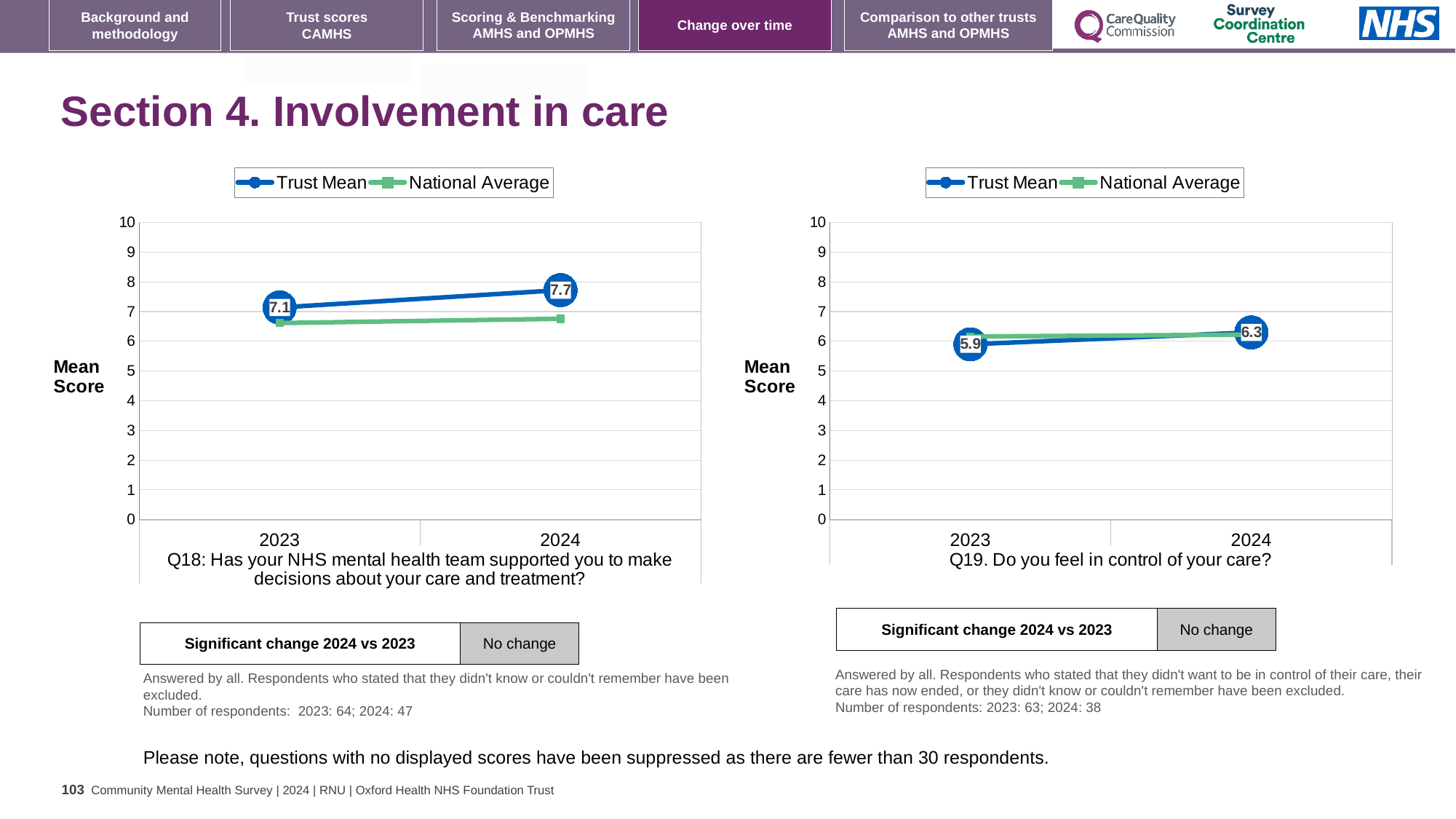
In the Q18 chart on the left, is the National Average for 2023 greater or less than 7? less How many series does the legend of the Q19 chart on the right list? 2 In the Q19 chart on the right, by how much did the Trust Mean change from 2023 to 2024? 0.4 In the Q18 chart on the left, which is higher in 2023, the Trust Mean or the National Average? Trust Mean In the Q18 chart on the left, what is the Trust Mean score for 2023? 7.1 How many years are plotted on the x axis of the Q18 chart on the left? 2 In the Q19 chart on the right, what is the Trust Mean score for 2023? 5.9 In the Q18 chart on the left, does the Trust Mean rise or fall from 2023 to 2024? rise What type of chart is the Q19 chart on the right? line chart In the Q18 chart on the left, by how much did the Trust Mean change from 2023 to 2024? 0.6 In the Q19 chart on the right, what is the Trust Mean score for 2024? 6.3 In the Q18 chart on the left, what is the Trust Mean score for 2024? 7.7